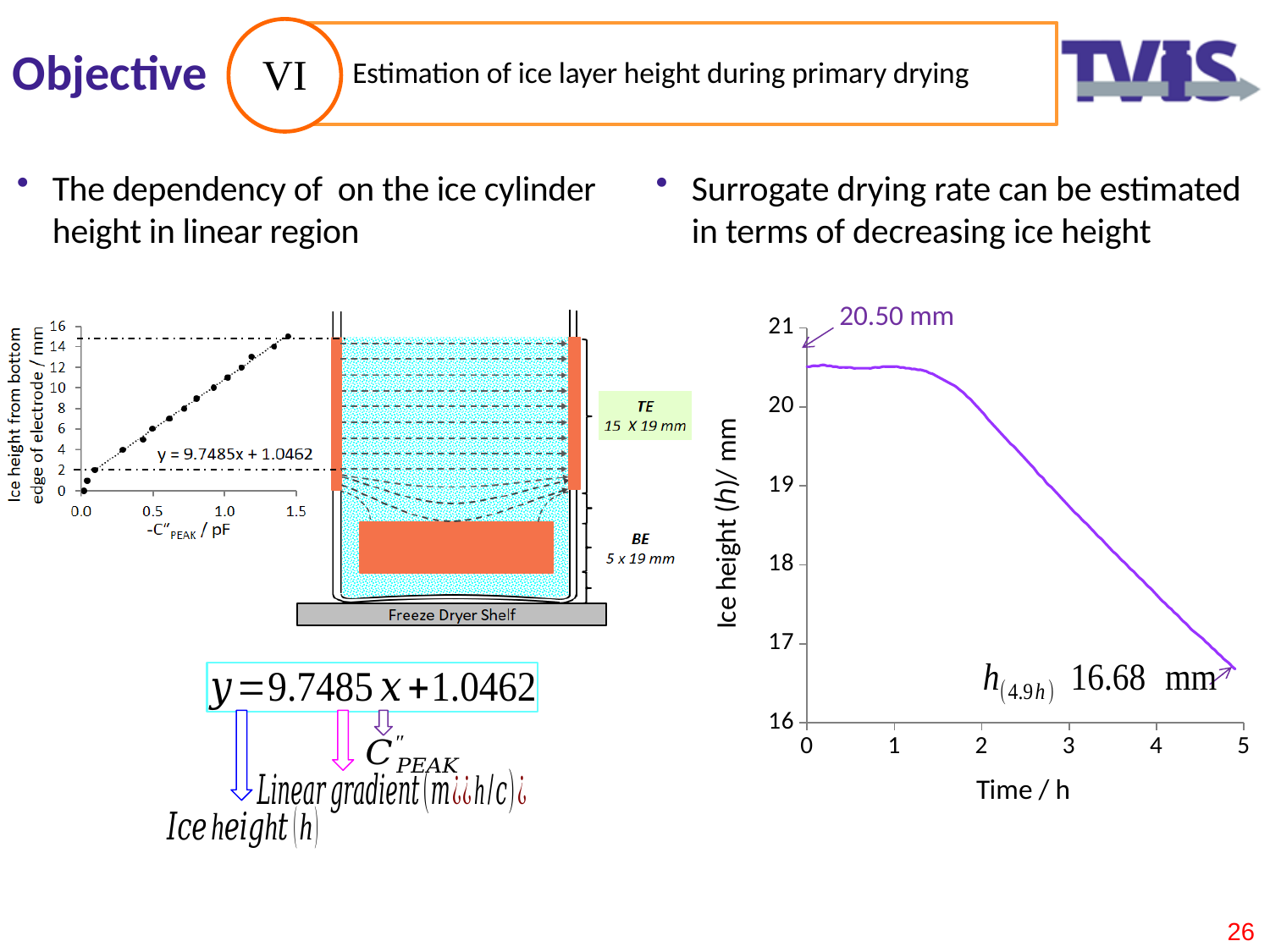
In the right-hand chart of ice height versus time, is the ice height at 3 h greater or less than 19? less In the left-hand chart of ice height versus -C''PEAK, what is the trendline equation shown? y = 9.7485x + 1.0462 In the right-hand chart of ice height versus time, do the values rise or fall as time increases? fall What is the x-axis label of the right-hand chart of ice height versus time? Time / h In the right-hand chart of ice height versus time, by how much does the ice height decrease between the labelled start value and the labelled value at 4.9 h? 3.82 mm What is the x-axis label of the left-hand chart of ice height versus -C''PEAK? -C''PEAK / pF In the right-hand chart of ice height versus time, is the ice height at 1 h greater or less than 20? greater In the left-hand chart of ice height versus -C''PEAK, do the plotted points rise or fall as -C''PEAK increases? rise What kind of chart is the left-hand chart of ice height versus -C''PEAK? scatter plot In the right-hand chart of ice height versus time, what is the ice height labelled at the start of the curve? 20.50 mm In the right-hand chart of ice height versus time, what is the ice height labelled at 4.9 h? 16.68 mm What kind of chart is the chart on the right of the slide, plotting ice height against time? line chart